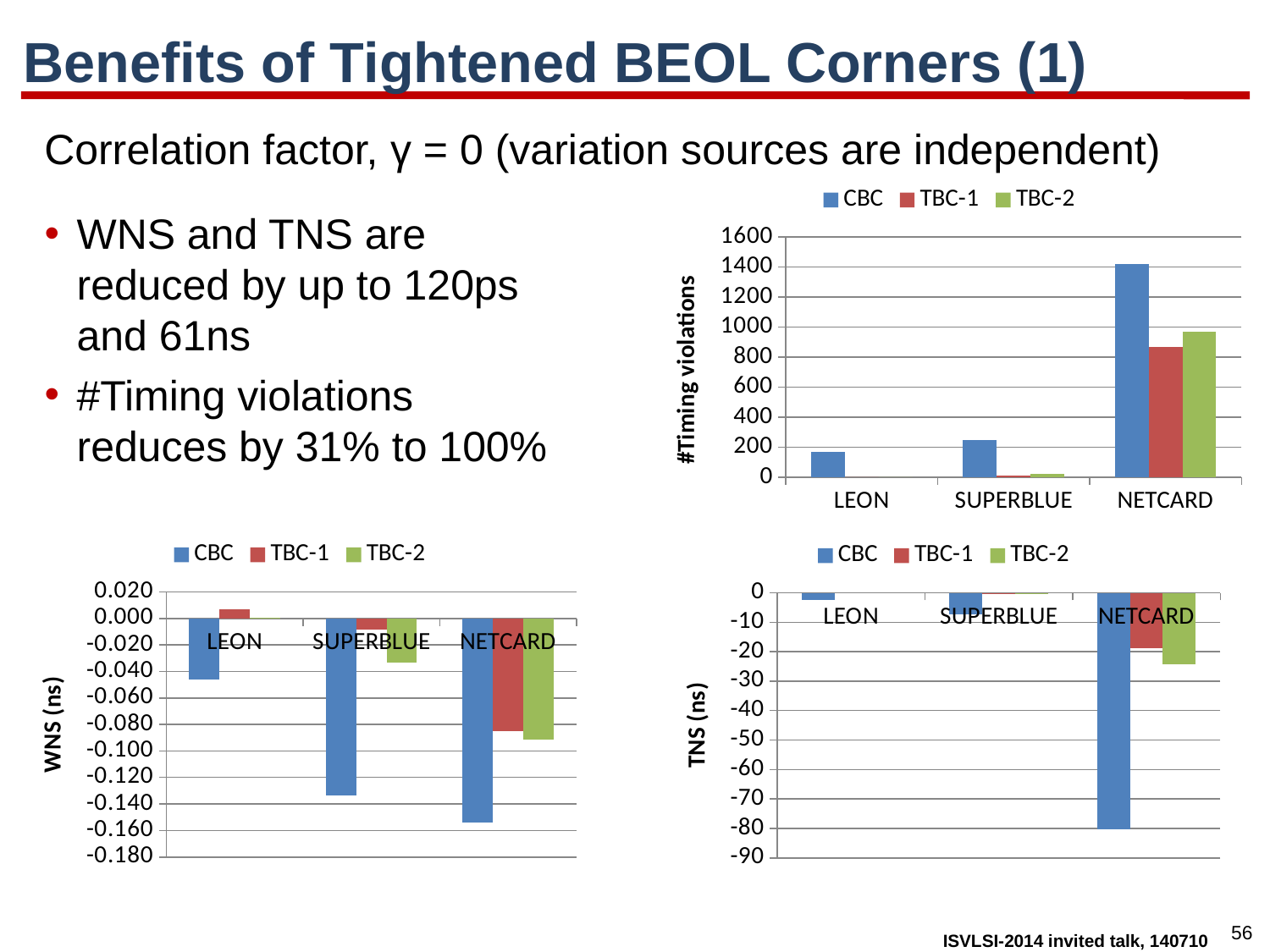
In the TNS (ns) chart (bottom right), is the CBC value for NETCARD greater or less than -70? less In the WNS (ns) chart (bottom left), which category has the lowest CBC value? NETCARD In the TNS (ns) chart (bottom right), which is larger for NETCARD, the TBC-1 value or the TBC-2 value? TBC-1 How many series does the legend of the #Timing violations chart (top right) list? 3 In the #Timing violations chart (top right), is the CBC value for SUPERBLUE greater or less than 400? less What kind of chart is the WNS (ns) chart (bottom left)? bar chart In the WNS (ns) chart (bottom left), is the CBC value for SUPERBLUE greater or less than -0.100? less What are the legend entries of the TNS (ns) chart (bottom right)? CBC, TBC-1, TBC-2 How many categories are shown on the x axis of the WNS (ns) chart (bottom left)? 3 In the #Timing violations chart (top right), which category has the highest CBC value? NETCARD